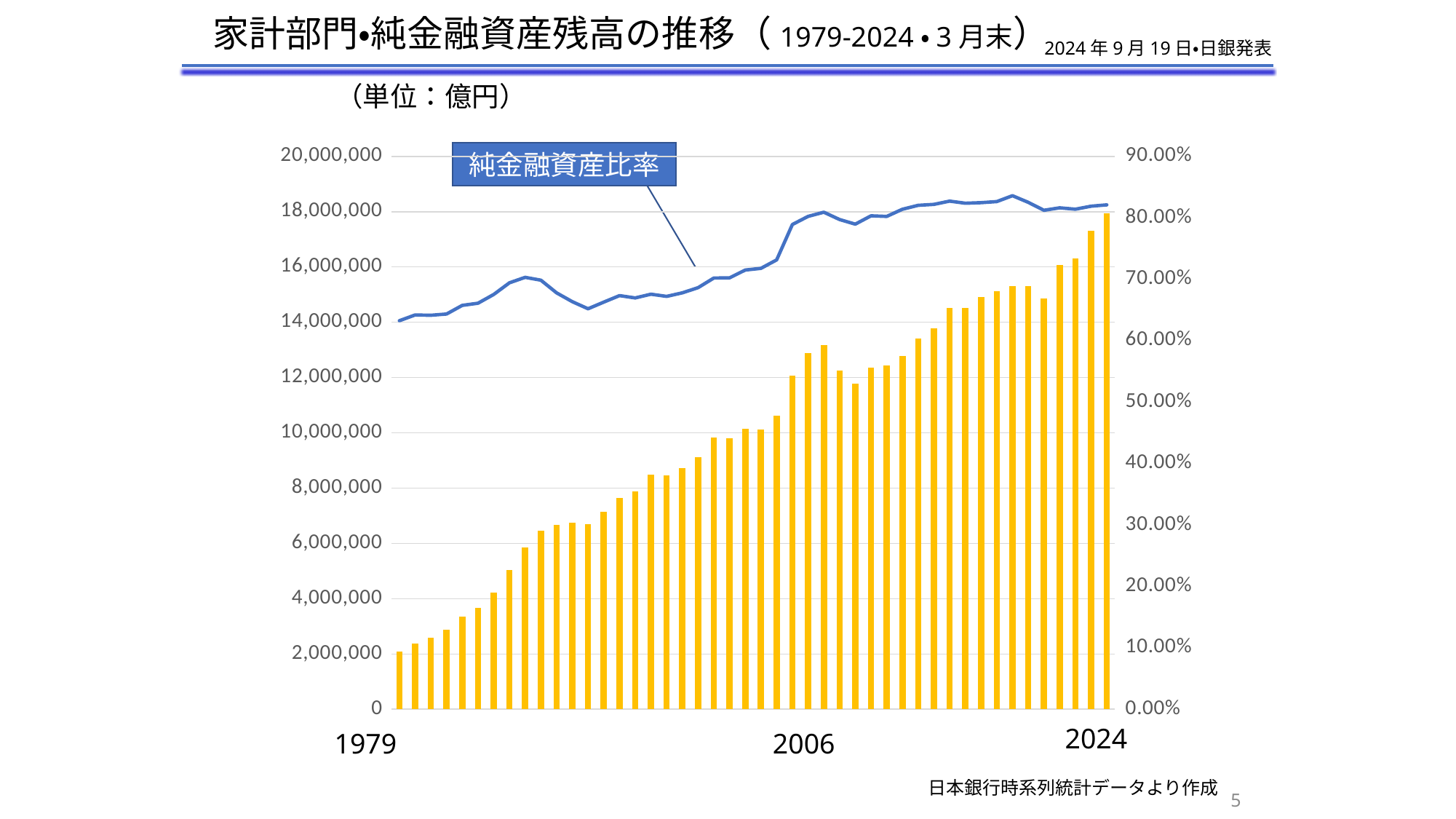
Which year has the highest bar for net financial assets? 2024 Is the bar value for 1979 greater or less than 4,000,000? less Is the 純金融資産比率 line value for 1979 greater or less than 50.00%? greater Which year has the lowest bar for net financial assets? 1979 Do the bar values generally rise or fall from 1979 to 2024? rise What label is given to the line series in the chart? 純金融資産比率 What kind of chart is shown on the slide? bar chart with a line Is the 純金融資産比率 line value for 2024 greater or less than 70.00%? greater What unit is stated for the bar values on the slide? 億円 Which year has the larger bar, 1979 or 2024? 2024